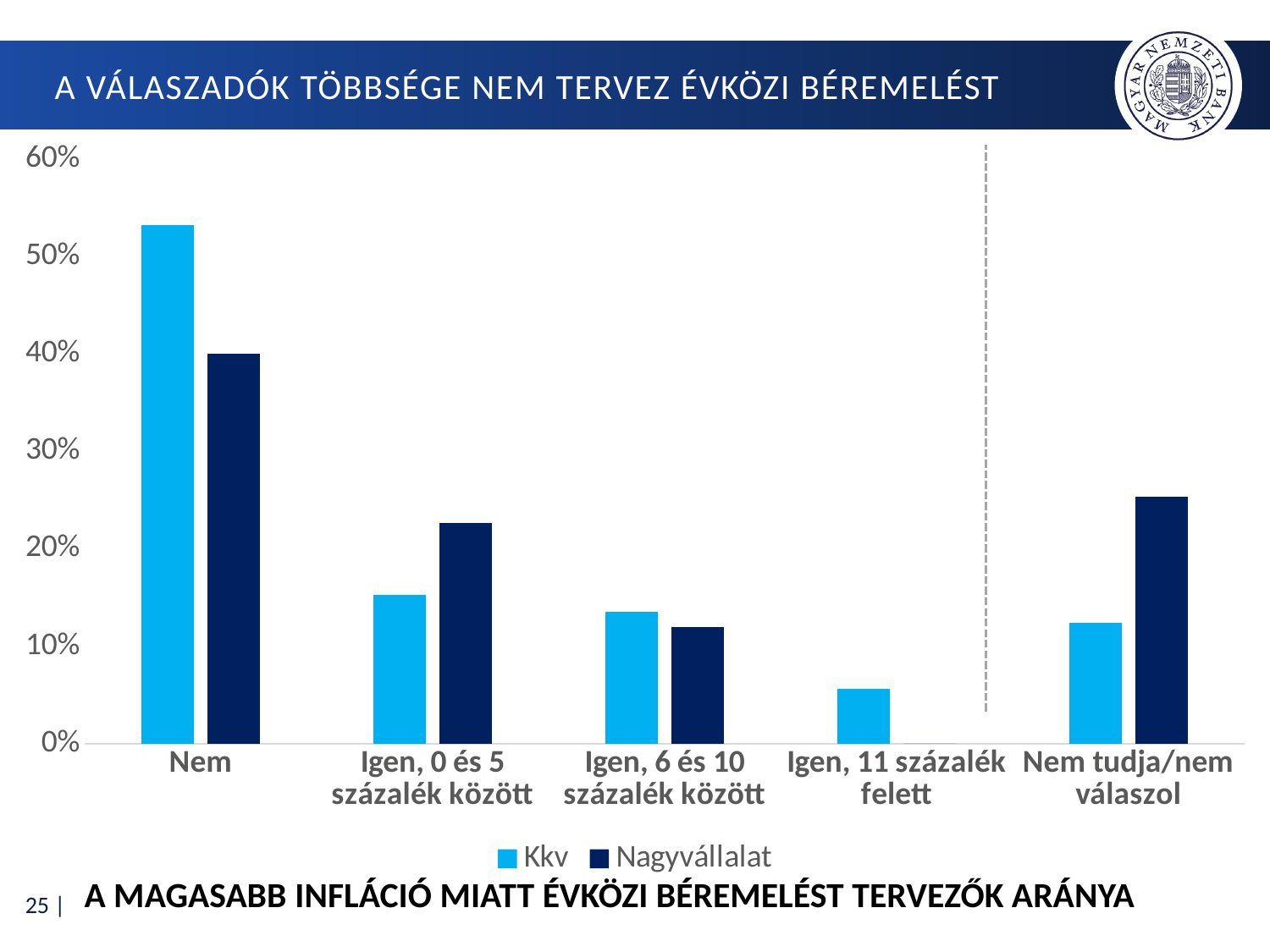
Is the Nagyvállalat value for Igen, 0 és 5 százalék között greater or less than 20%? greater Which category has the lowest value for the Kkv series? Igen, 11 százalék felett Is the Kkv value for Igen, 11 százalék felett greater or less than 10%? less For the category Nem, which series has the larger value, Kkv or Nagyvállalat? Kkv Which category has the highest value for the Nagyvállalat series? Nem How many series does the legend list? 2 For the category Nem tudja/nem válaszol, which series has the larger value, Kkv or Nagyvállalat? Nagyvállalat Which category has the highest value for the Kkv series? Nem How many categories are shown on the x axis? 5 What are the two series named in the legend? Kkv and Nagyvállalat What kind of chart is shown on the slide? bar chart Is the Kkv value for Nem greater or less than 50%? greater